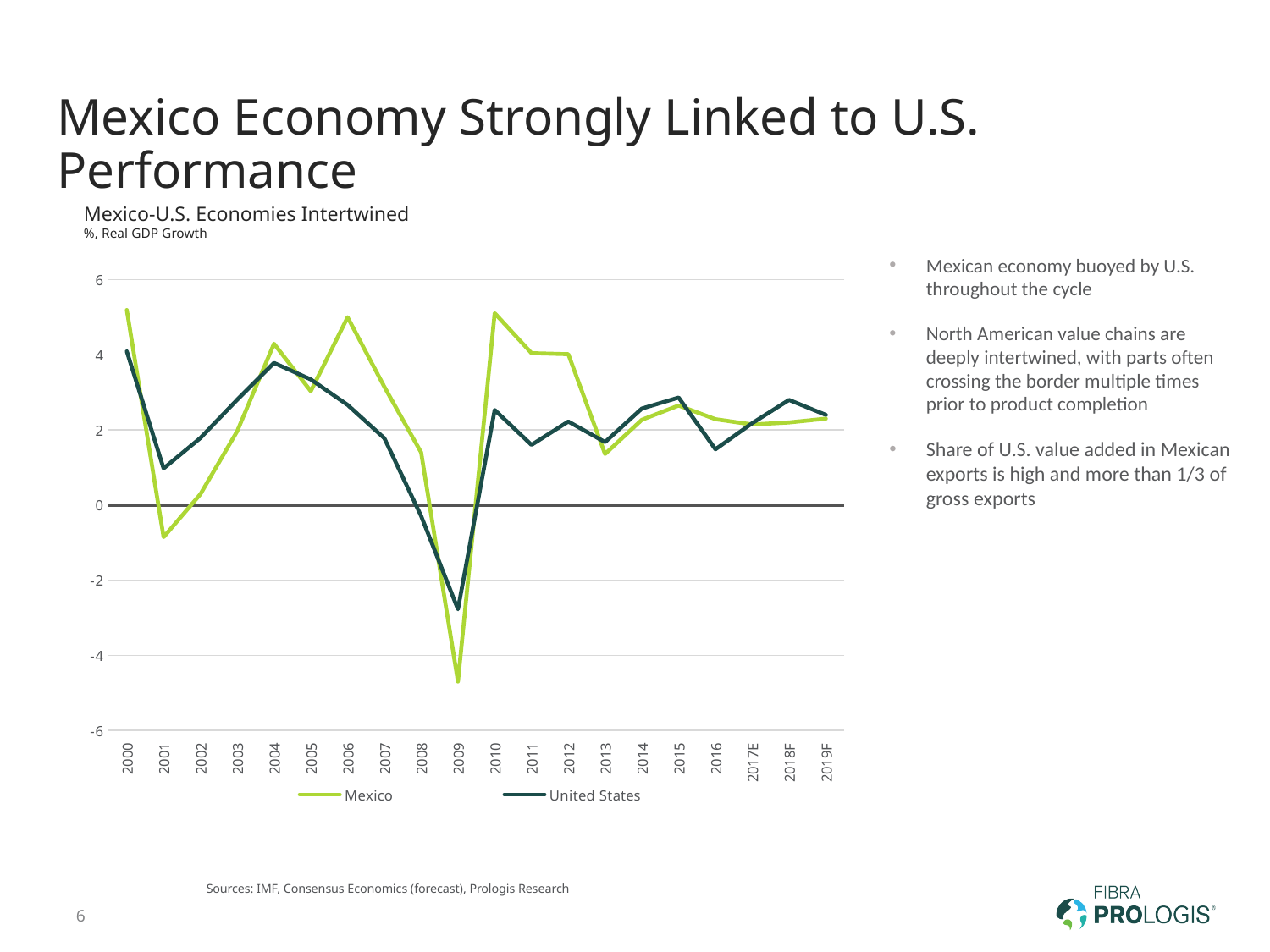
Is the value for Mexico in 2009 greater or less than -4? less What kind of chart is shown on the slide? line chart Do the values for Mexico rise or fall from 2006 to 2009? fall Is the value for Mexico in 2006 greater or less than 4? greater What unit is the chart's y axis measured in, according to the subtitle? %, Real GDP Growth Is the value for the United States in 2009 greater or less than -2? less How many years are shown on the x axis of the chart? 20 In which year does the United States line reach its lowest value? 2009 What is the title of the chart? Mexico-U.S. Economies Intertwined In which year does the Mexico line reach its lowest value? 2009 In 2006, which series has the higher value, Mexico or United States? Mexico How many series does the legend list? 2